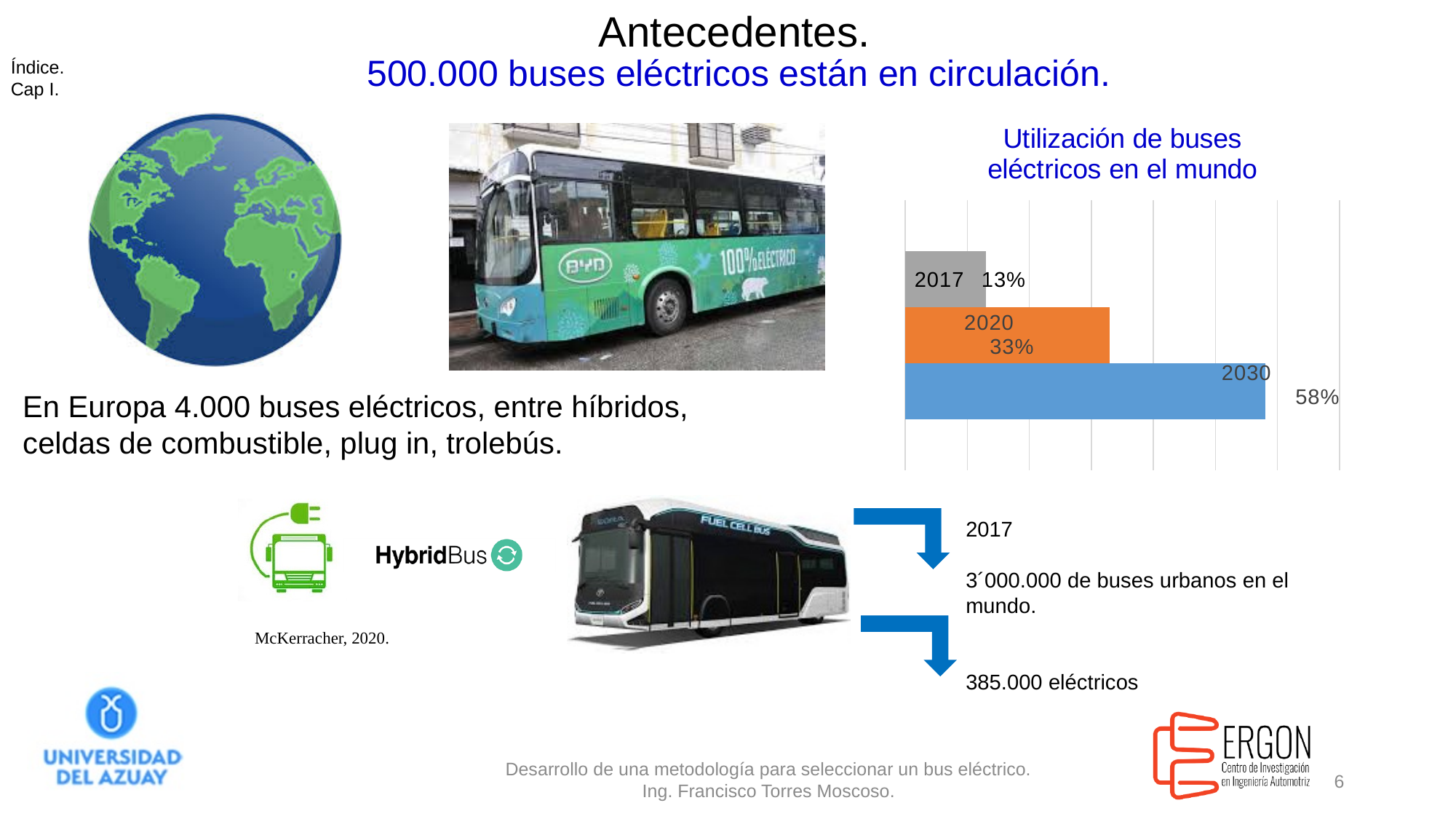
What is the difference between the values for 2020 and 2017? 20% What value does the chart show for 2020? 33% Do the values rise or fall from 2017 to 2030? Rise What kind of chart is shown on the slide? Bar chart What value does the chart show for 2030? 58% Which year has the lowest value in the chart? 2017 What is the difference between the values for 2030 and 2020? 25% What value does the chart show for 2017? 13% How many bars does the chart have? 3 Which year has the highest value in the chart? 2030 Which is larger, the value for 2020 or the value for 2017? 2020 What is the title of the chart? Utilización de buses eléctricos en el mundo